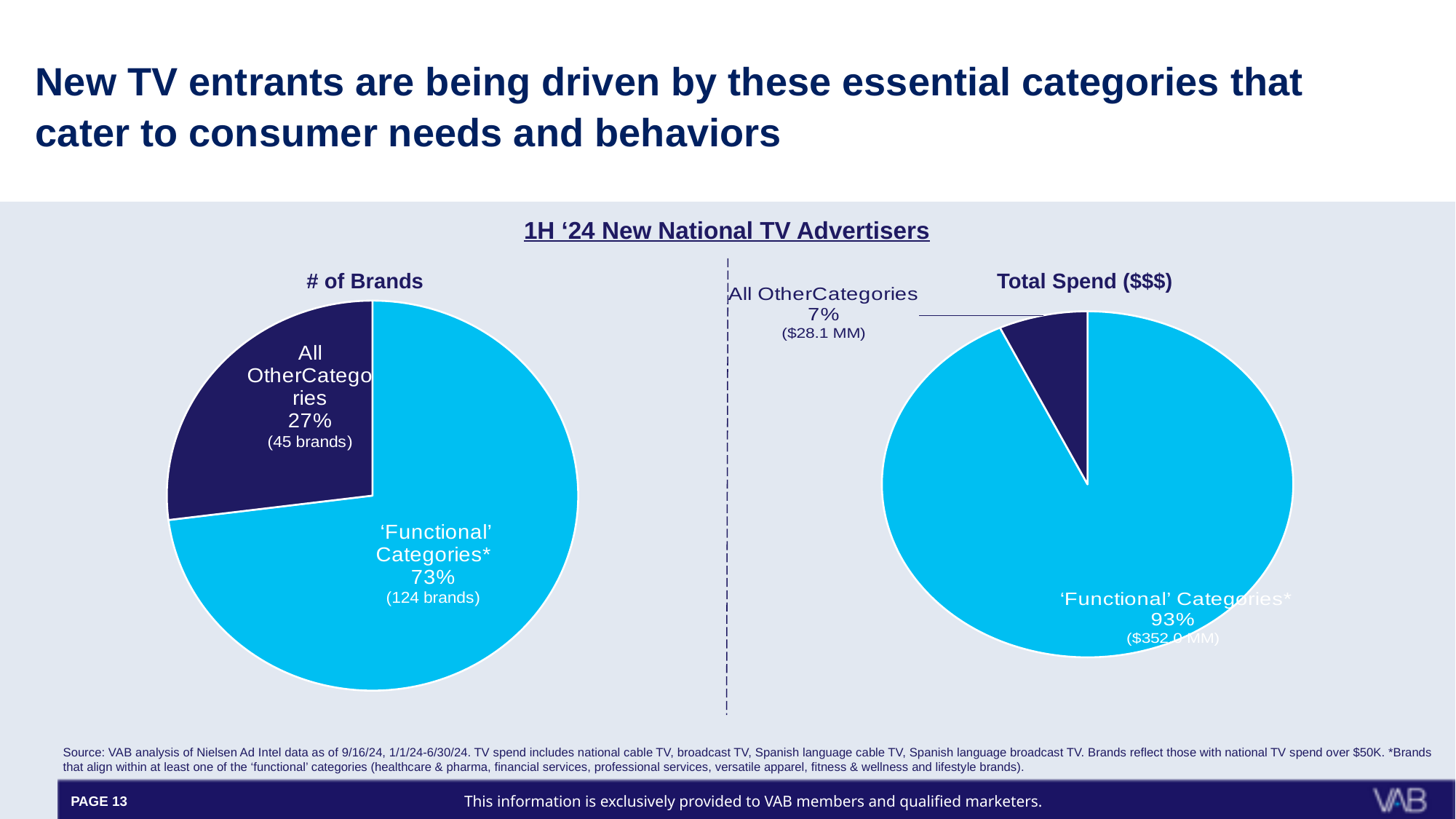
How many slices does the 'Total Spend ($$$)' pie chart have? 2 In the '# of Brands' chart, how many brands are in All Other Categories? 45 brands In the '# of Brands' chart, which category has the smallest slice? All Other Categories In the 'Total Spend ($$$)' chart, what share of spend comes from All Other Categories? 7% In the 'Total Spend ($$$)' chart, which category has the largest slice? 'Functional' Categories* What type of chart is used for '# of Brands'? Pie chart In the 'Total Spend ($$$)' chart, what is the spend for 'Functional' Categories? $352.0 MM In the '# of Brands' chart, what share of brands falls in 'Functional' Categories? 73% In the '# of Brands' chart, how many more brands are in 'Functional' Categories than in All Other Categories? 79 brands In the '# of Brands' chart, how many brands are in 'Functional' Categories? 124 brands What is the overall title above the two pie charts? 1H '24 New National TV Advertisers In the 'Total Spend ($$$)' chart, what is the spend for All Other Categories? $28.1 MM